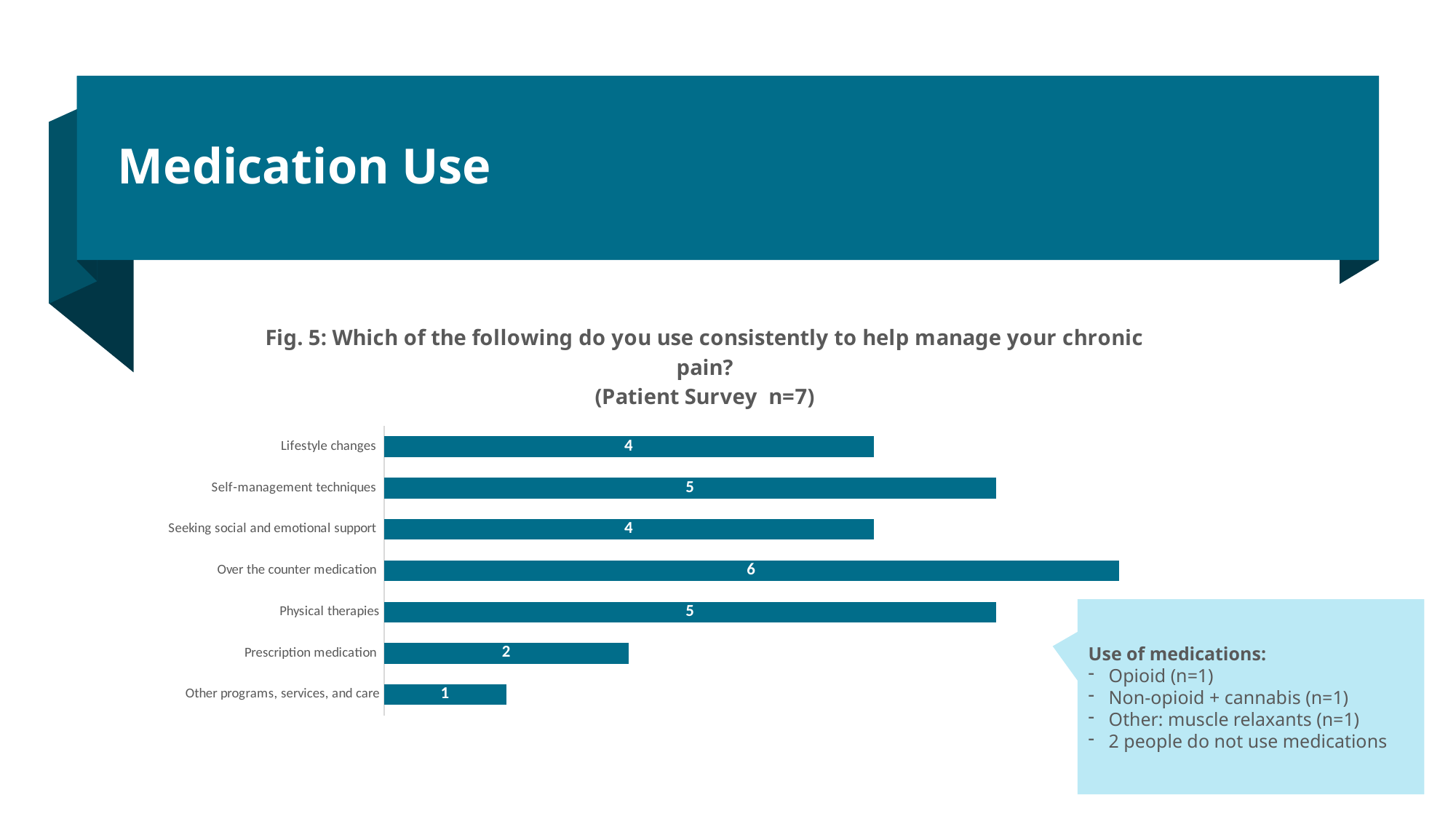
What is the value for Other programs, services, and care? 1 What is the sample size (n) stated in the chart title? n=7 What is the value for Over the counter medication? 6 What is the difference between the values for Self-management techniques and Seeking social and emotional support? 1 Which is larger, the value for Physical therapies or the value for Lifestyle changes? Physical therapies Which category has the lowest value? Other programs, services, and care What kind of chart is shown on the slide? Bar chart What is the difference between the values for Over the counter medication and Prescription medication? 4 How many categories are shown in the chart? 7 Which category has the highest value? Over the counter medication What is the value for Self-management techniques? 5 What is the value for Prescription medication? 2